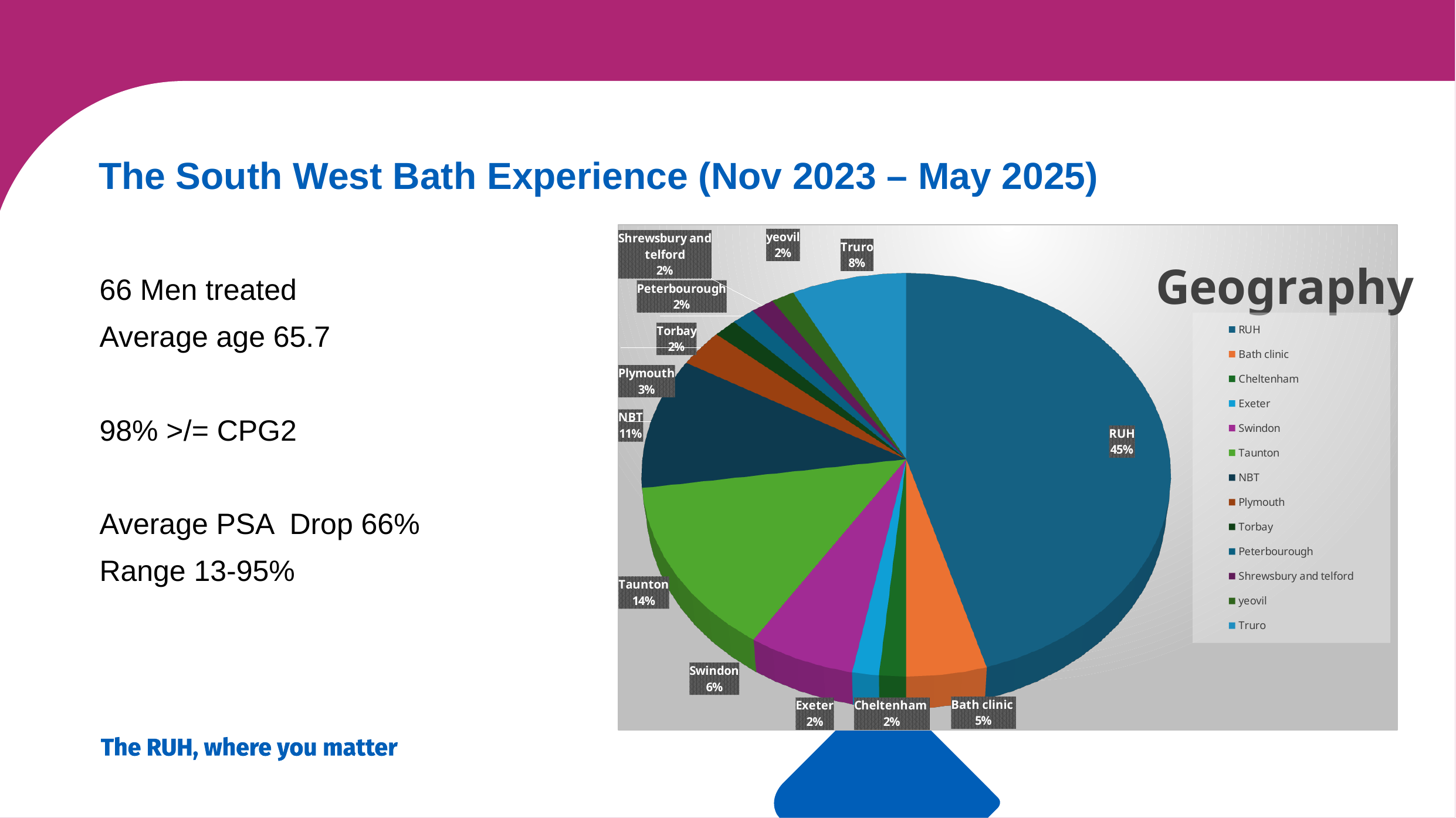
What percentage is shown for Truro? 8% What is the difference in percentage points between RUH and Taunton? 31 What percentage is shown for NBT? 11% What percentage is shown for Bath clinic? 5% What percentage is shown for Taunton? 14% Which category has the largest slice of the pie? RUH What percentage is shown for Plymouth? 3% What share of the pie does RUH account for? 45% How many categories does the legend list? 13 What kind of chart is shown on the slide? Pie chart Which is larger, the share for Swindon or the share for Plymouth? Swindon What is the title of the chart? Geography